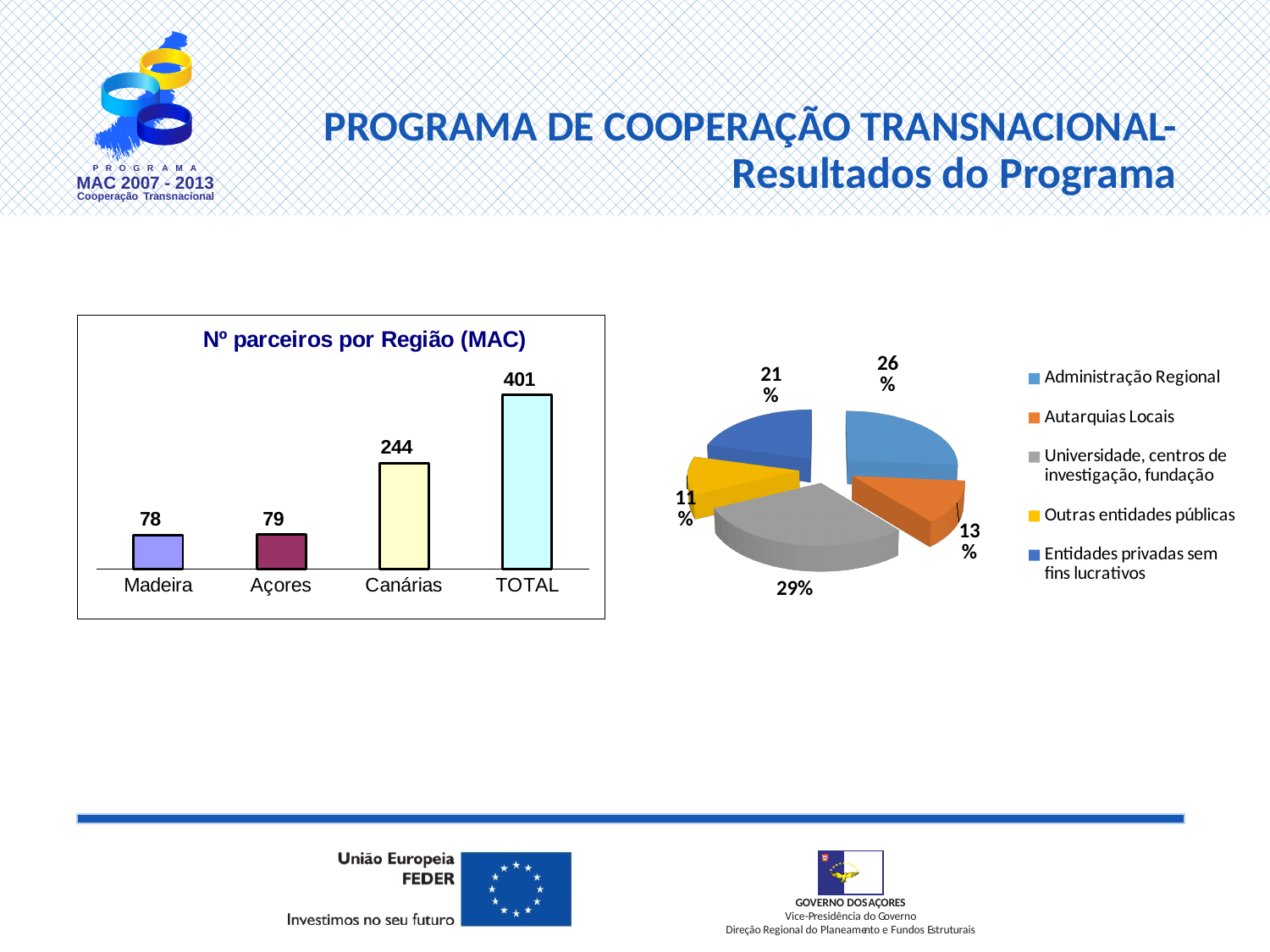
In the bar chart 'Nº parceiros por Região (MAC)', what is the difference between the values for Canárias and Açores? 165 In the pie chart on the right, what share does 'Universidade, centros de investigação, fundação' have? 29% How many entries does the legend of the pie chart on the right list? 5 In the bar chart 'Nº parceiros por Região (MAC)', what is the value for Canárias? 244 In the bar chart 'Nº parceiros por Região (MAC)', which region (excluding TOTAL) has the highest number of partners? Canárias In the pie chart on the right, what share does 'Outras entidades públicas' have? 11% What kind of chart is the chart on the left of the slide? Bar chart In the bar chart 'Nº parceiros por Região (MAC)', which category has the lowest value? Madeira In the bar chart 'Nº parceiros por Região (MAC)', what is the value for Madeira? 78 In the bar chart 'Nº parceiros por Região (MAC)', how many categories are shown on the x axis? 4 In the pie chart on the right, which category has the smallest share? Outras entidades públicas In the bar chart 'Nº parceiros por Região (MAC)', what is the value for TOTAL? 401